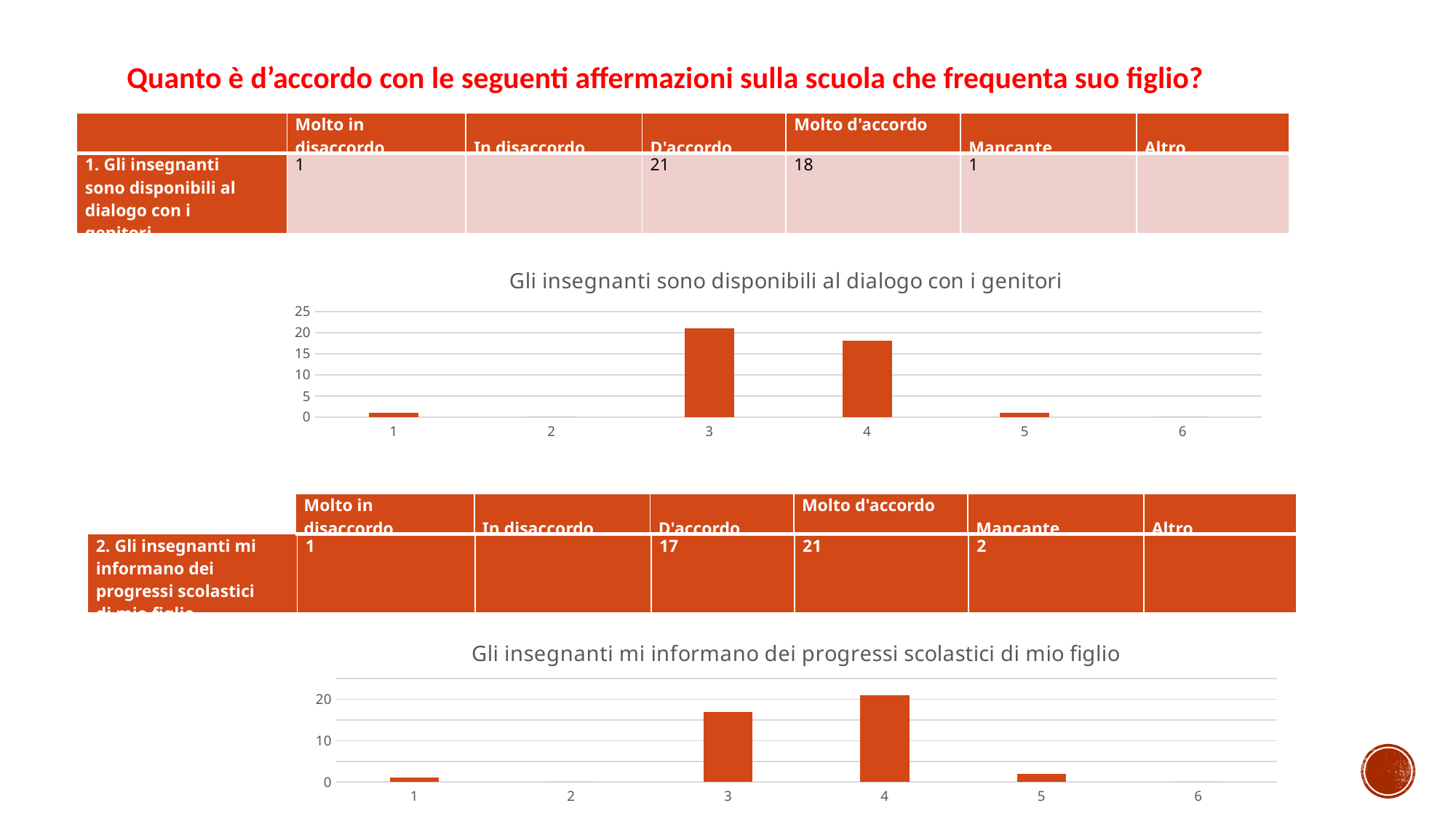
In the chart titled "Gli insegnanti sono disponibili al dialogo con i genitori", how many categories are shown on the x axis? 6 What is the title of the lower chart on the slide? Gli insegnanti mi informano dei progressi scolastici di mio figlio In the chart titled "Gli insegnanti mi informano dei progressi scolastici di mio figlio", what is the difference between the values for category 4 and category 3? 4 In the chart titled "Gli insegnanti sono disponibili al dialogo con i genitori", is the value for category 4 greater or less than 15? greater In the chart titled "Gli insegnanti mi informano dei progressi scolastici di mio figlio", what is the value for category 4? 21 What kind of chart is the chart titled "Gli insegnanti sono disponibili al dialogo con i genitori"? bar chart In the chart titled "Gli insegnanti mi informano dei progressi scolastici di mio figlio", which is larger, the value for category 3 or category 4? 4 In the chart titled "Gli insegnanti sono disponibili al dialogo con i genitori", what is the value for category 3? 21 In the chart titled "Gli insegnanti mi informano dei progressi scolastici di mio figlio", which category has the highest bar? 4 In the chart titled "Gli insegnanti sono disponibili al dialogo con i genitori", which category has the highest bar? 3 In the chart titled "Gli insegnanti sono disponibili al dialogo con i genitori", what is the difference between the values for category 3 and category 4? 3 In the chart titled "Gli insegnanti mi informano dei progressi scolastici di mio figlio", is the value for category 3 greater or less than 10? greater